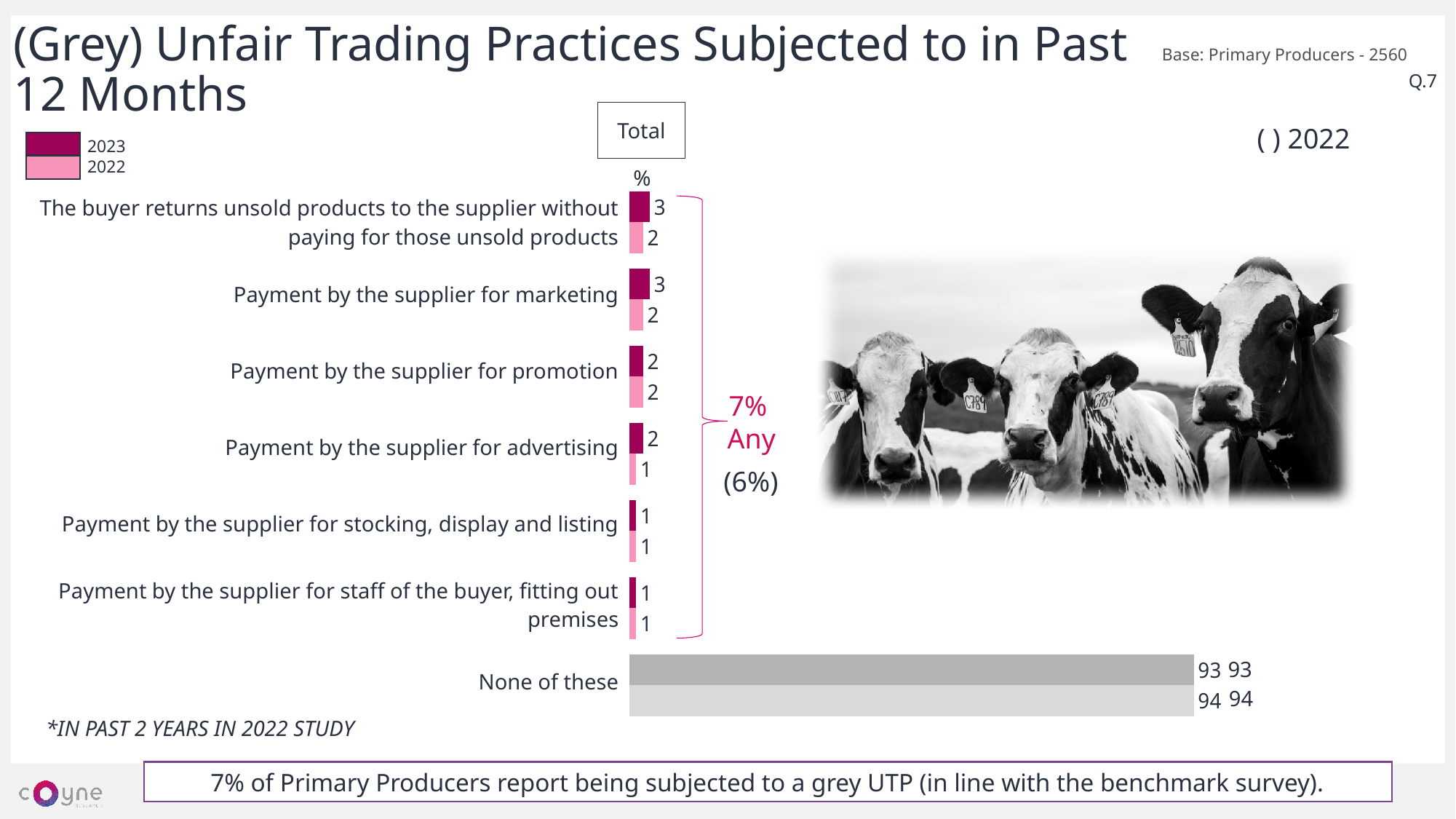
How many categories are plotted in the chart? 7 What is the 2022 value for 'None of these'? 94 What is the 2023 value for 'None of these'? 93 What is the 2022 value for 'Payment by the supplier for marketing'? 2 How many series does the legend list? 2 Which category has the highest 2023 value? None of these What is the 2023 value for 'Payment by the supplier for advertising'? 2 What percentage is shown for 'Any' grey unfair trading practice in 2023? 7% What is the difference between the 2023 and 2022 values for 'Payment by the supplier for advertising'? 1 What kind of chart is shown on the slide? bar chart Which is larger for 'None of these': the 2023 value or the 2022 value? 2022 What is the 2023 value for 'The buyer returns unsold products to the supplier without paying for those unsold products'? 3